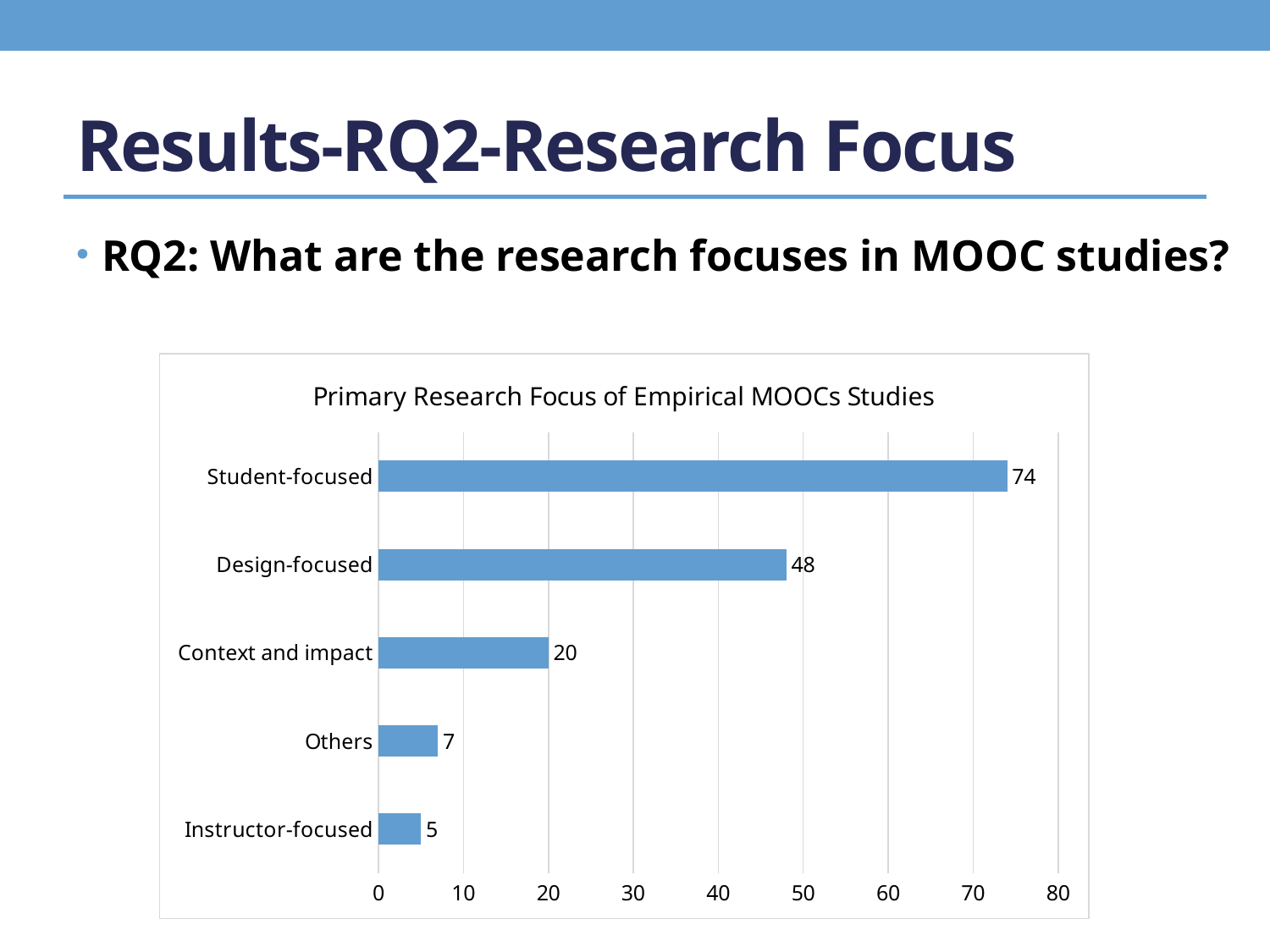
What is the difference between the values for Student-focused and Design-focused? 26 Which is larger, the value for Context and impact or the value for Others? Context and impact What is the difference between the values for Others and Instructor-focused? 2 What kind of chart is shown on the slide? Bar chart What is the value for Student-focused? 74 What is the value for Design-focused? 48 Which category has the highest value? Student-focused What is the value for Instructor-focused? 5 What is the title of the chart? Primary Research Focus of Empirical MOOCs Studies Which category has the lowest value? Instructor-focused How many categories are shown in the chart? 5 What is the value for Context and impact? 20